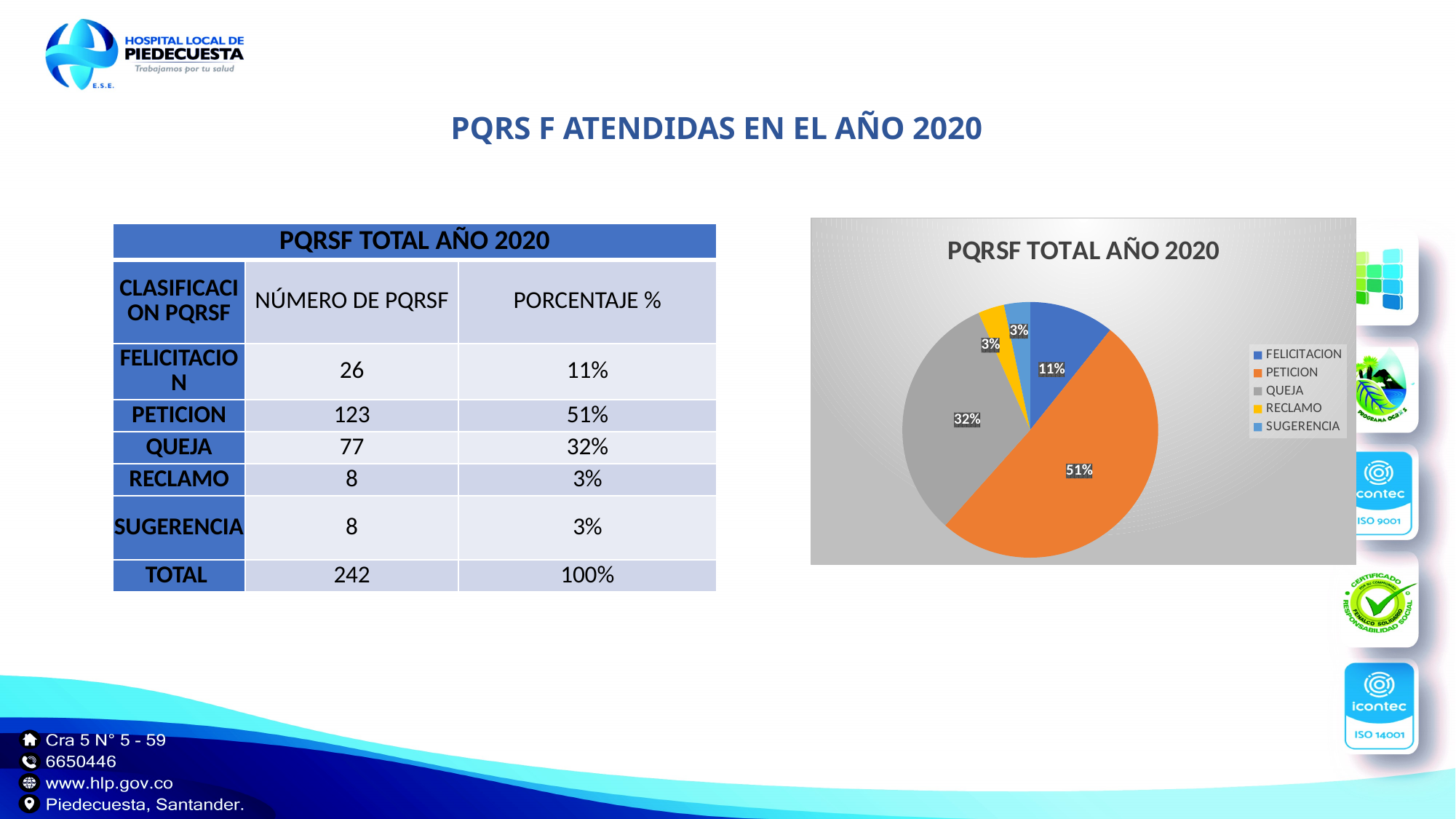
What is the title of the chart? PQRSF TOTAL AÑO 2020 What kind of chart is shown on the slide? pie chart What percentage does the QUEJA slice show? 32% What is the combined share of the RECLAMO and SUGERENCIA slices? 6% What is the difference in percentage points between the PETICION and QUEJA slices? 19% How many categories does the legend list? 5 What percentage does the RECLAMO slice show? 3% What colour is the PETICION slice? orange Which category has the largest slice of the pie? PETICION What percentage does the PETICION slice show? 51% What percentage does the FELICITACION slice show? 11% Which slice is larger, QUEJA or FELICITACION? QUEJA